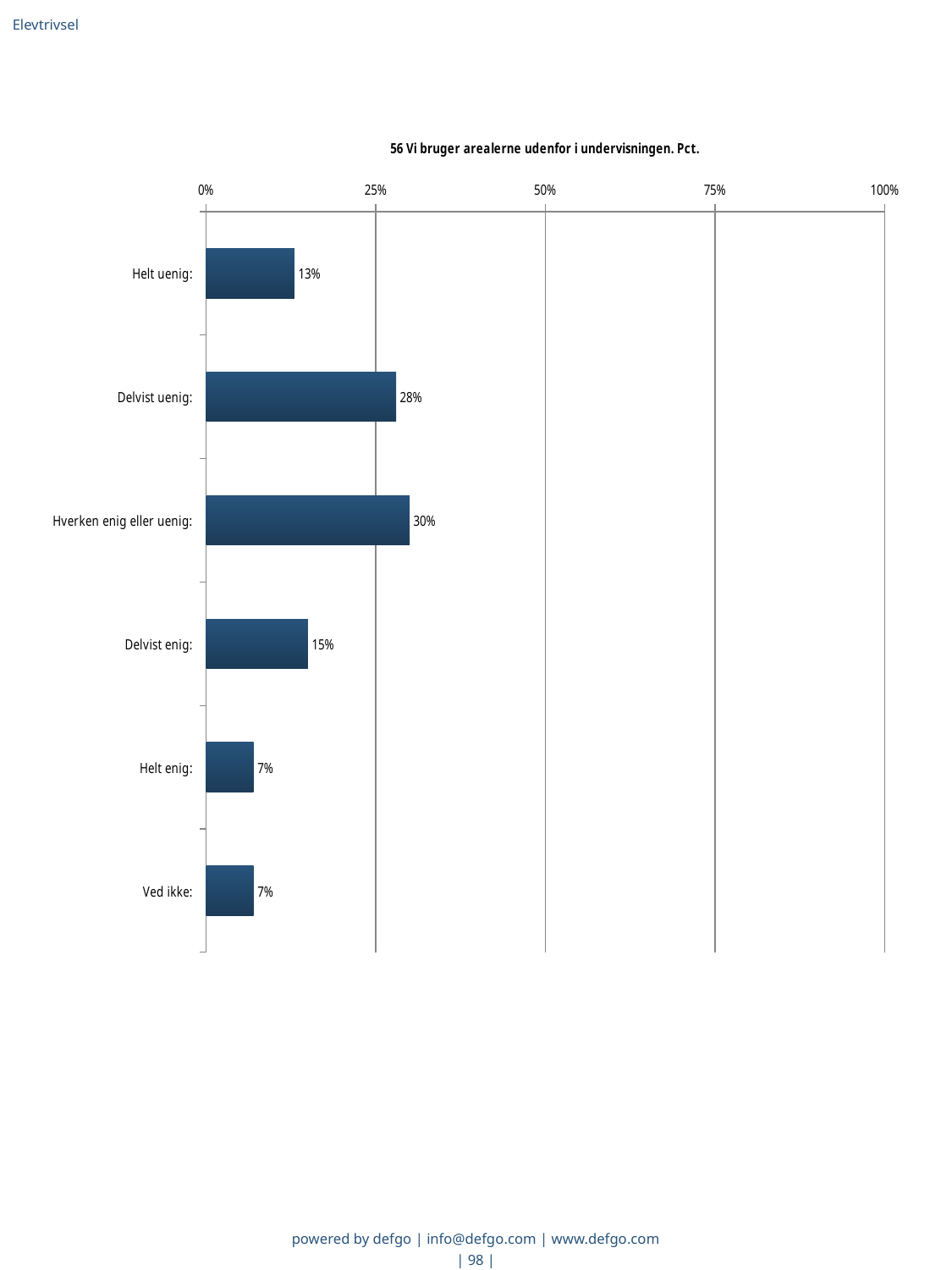
Which category has the highest value? Hverken enig eller uenig What is the value for "Ved ikke"? 7% What is the value for "Delvist uenig"? 28% Is the value for "Hverken enig eller uenig" greater or less than 25%? greater What is the title of the chart? 56 Vi bruger arealerne udenfor i undervisningen. Pct. What is the value for "Helt uenig"? 13% What is the value for "Delvist enig"? 15% Which is larger, the value for "Delvist enig" or the value for "Helt enig"? Delvist enig What is the difference between the values for "Hverken enig eller uenig" and "Helt uenig"? 17% Is the value for "Delvist enig" greater or less than 25%? less What kind of chart is shown on the slide? Bar chart How many categories are shown in the chart? 6